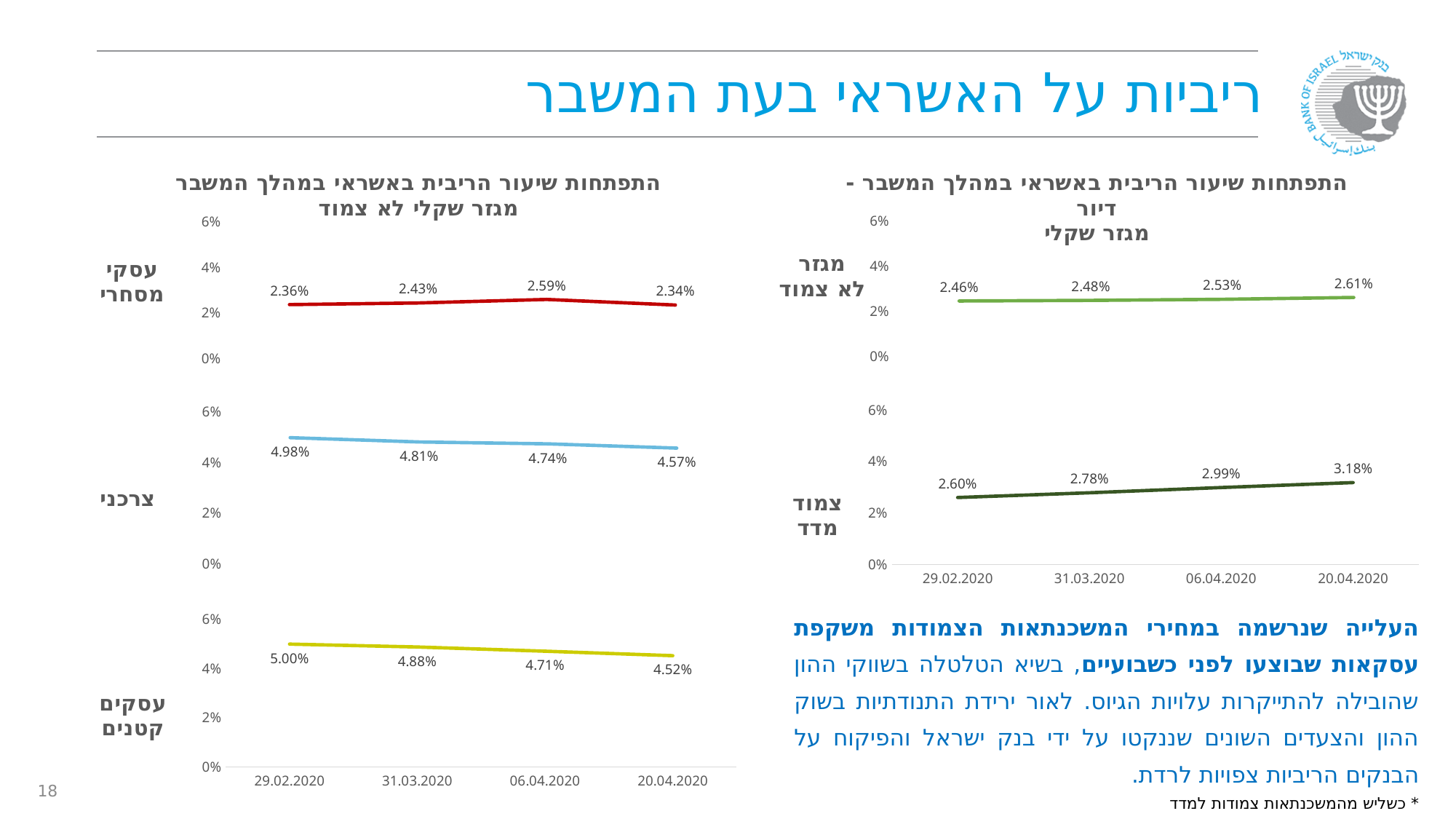
In the right chart (דיור מגזר שקלי), what is the difference between the צמוד מדד values on 20.04.2020 and 29.02.2020? 0.58% In the left chart (מגזר שקלי לא צמוד), what is the value for צרכני on 29.02.2020? 4.98% In the left chart (מגזר שקלי לא צמוד), what is the value for עסקים קטנים on 20.04.2020? 4.52% In the right chart (דיור מגזר שקלי), on which date is the value for צמוד מדד highest? 20.04.2020 In the left chart (מגזר שקלי לא צמוד), on which date is the value for עסקי מסחרי lowest? 20.04.2020 In the left chart (מגזר שקלי לא צמוד), what is the value for עסקי מסחרי on 06.04.2020? 2.59% In the left chart (מגזר שקלי לא צמוד), which is larger on 31.03.2020: the value for צרכני or the value for עסקים קטנים? עסקים קטנים In the right chart (דיור מגזר שקלי), what is the value for מגזר לא צמוד on 20.04.2020? 2.61% What type of chart is used on this slide? Line chart In the left chart (מגזר שקלי לא צמוד), do the values for צרכני rise or fall from 29.02.2020 to 20.04.2020? Fall In the right chart (דיור מגזר שקלי), what is the value for צמוד מדד on 31.03.2020? 2.78% How many dates are shown on the x axis of the left chart (מגזר שקלי לא צמוד)? 4